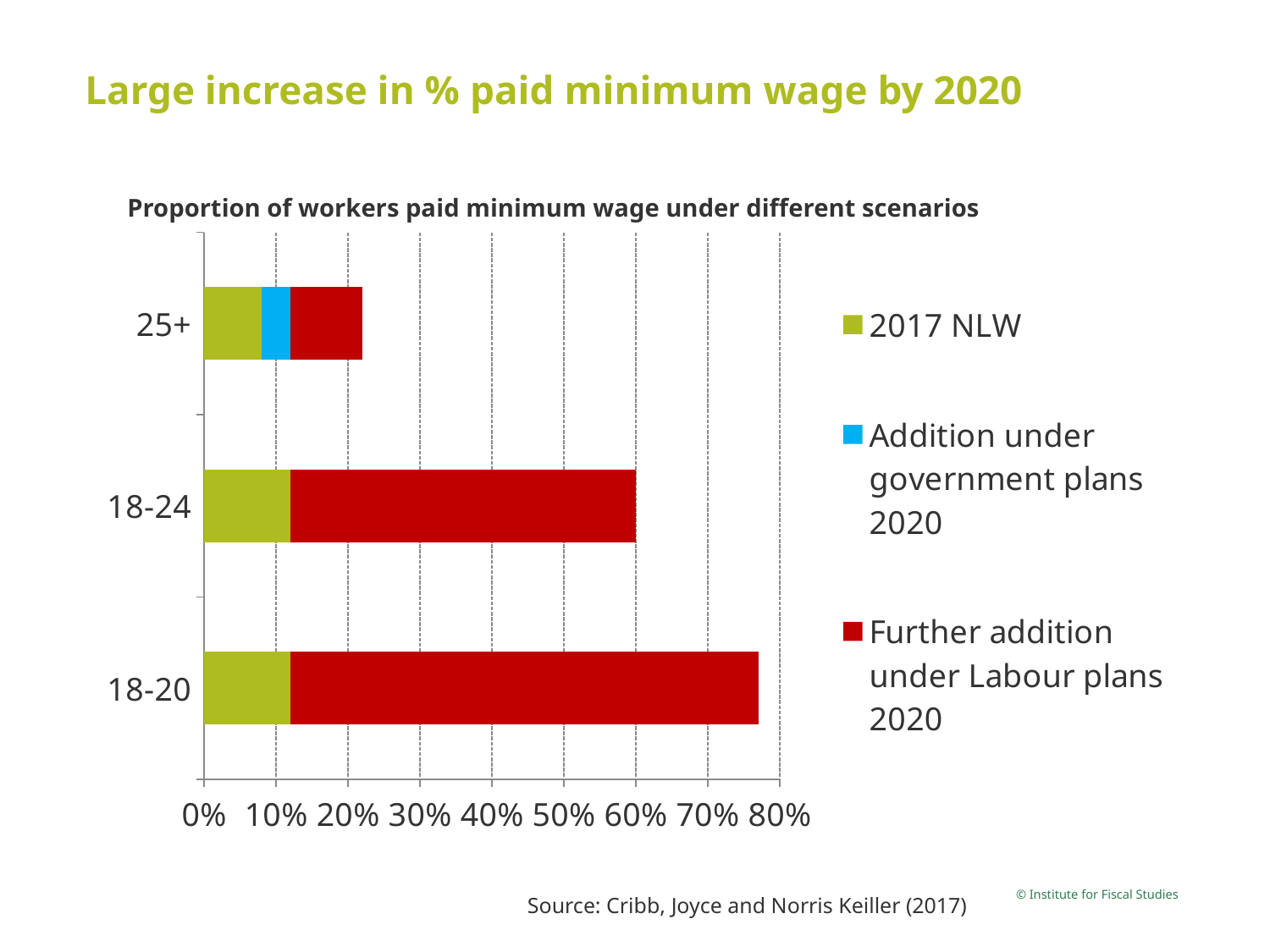
How many age groups are shown on the chart? 3 What is the title of the chart? Proportion of workers paid minimum wage under different scenarios Is the total value for the 25+ bar greater or less than 30%? less Is the total value for the 18-24 bar greater or less than 50%? greater What kind of chart is shown on the slide? Stacked bar chart Which age group has a larger total bar, 18-24 or 25+? 18-24 Which age group has the highest total proportion of workers paid minimum wage? 18-20 Which age group shows a visible 'Addition under government plans 2020' segment? 25+ Is the total value for the 18-20 bar greater or less than 70%? greater Which age group has the lowest total proportion of workers paid minimum wage? 25+ How many series does the legend list? 3